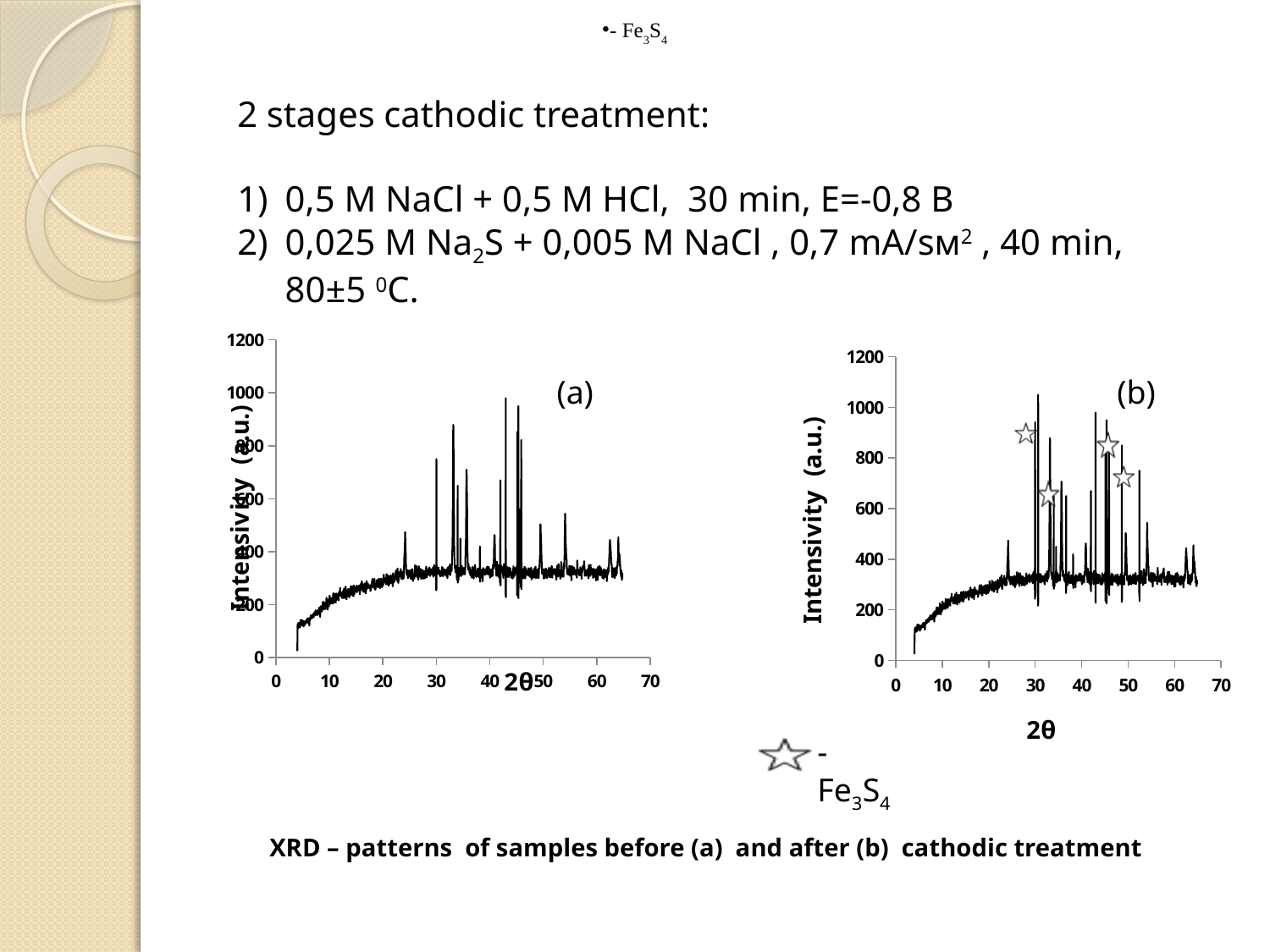
What kind of chart is chart (b)? line chart How many star markers (Fe3S4) are placed on chart (b)? 4 On chart (a), is the tallest peak greater or less than 800? greater On chart (a), what is the highest value shown on the y axis? 1200 How many charts are shown on the slide? 2 On chart (b), is the intensity at 2θ = 5 greater or less than 200? less What is the label of the y axis on chart (b)? Intensivity (a.u.) On chart (b), does the baseline intensity rise or fall between 2θ = 5 and 2θ = 20? rise What is the label of the x axis on chart (b)? 2θ What kind of chart is chart (a)? line chart On chart (a), is the baseline intensity at 2θ = 60 greater or less than 400? less